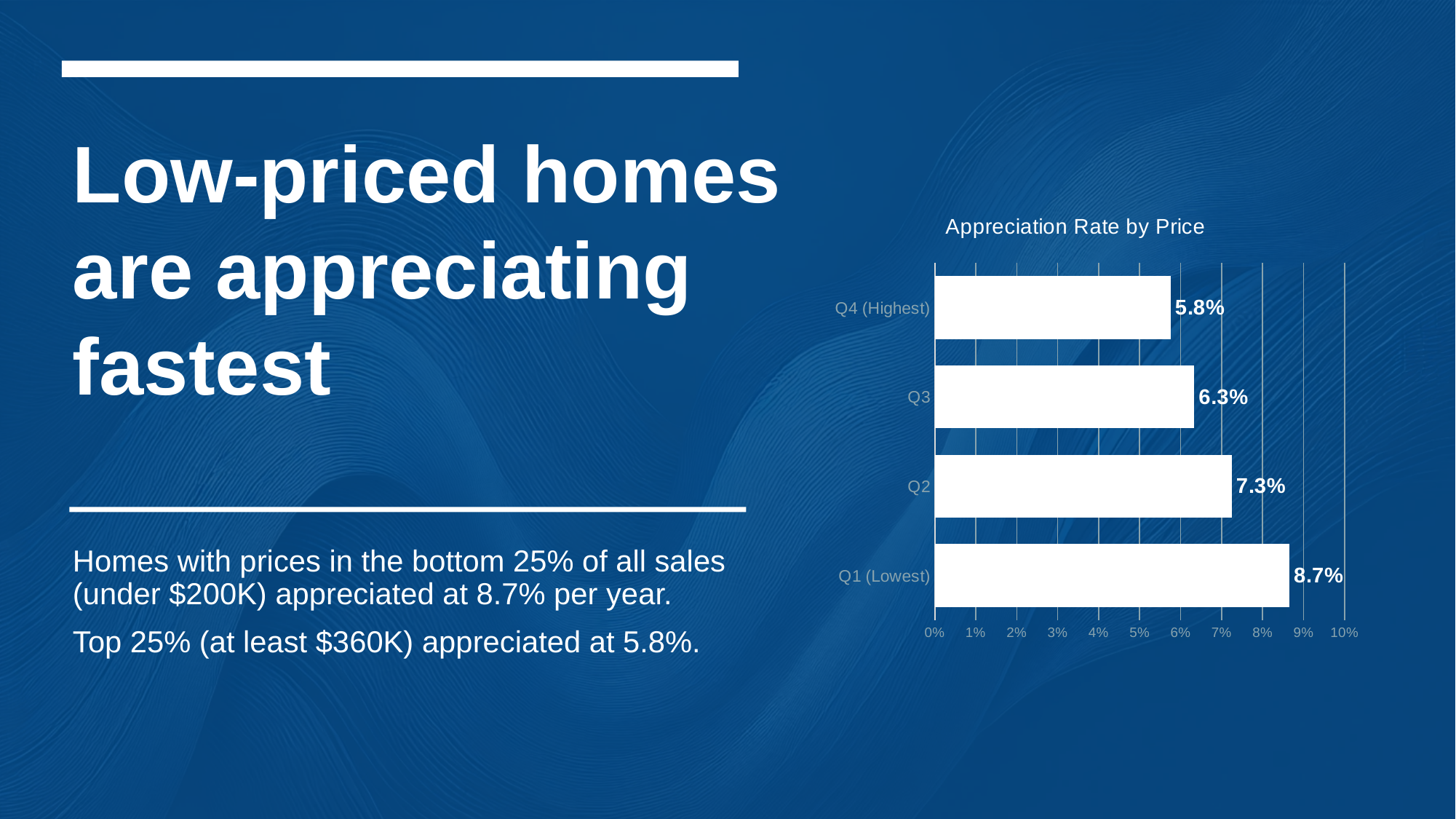
Is the appreciation rate for Q3 greater or less than 7%? less What is the difference in appreciation rate between Q2 and Q3? 1.0% What is the appreciation rate for Q1 (Lowest)? 8.7% Which price quartile has the highest appreciation rate? Q1 (Lowest) What type of chart is shown on the slide? Bar chart What is the appreciation rate for Q3? 6.3% How many price quartiles are shown in the chart? 4 What is the difference in appreciation rate between Q1 (Lowest) and Q4 (Highest)? 2.9% Which price quartile has the lowest appreciation rate? Q4 (Highest) What is the appreciation rate for Q2? 7.3% Which has a higher appreciation rate, Q2 or Q3? Q2 What is the appreciation rate for Q4 (Highest)? 5.8%